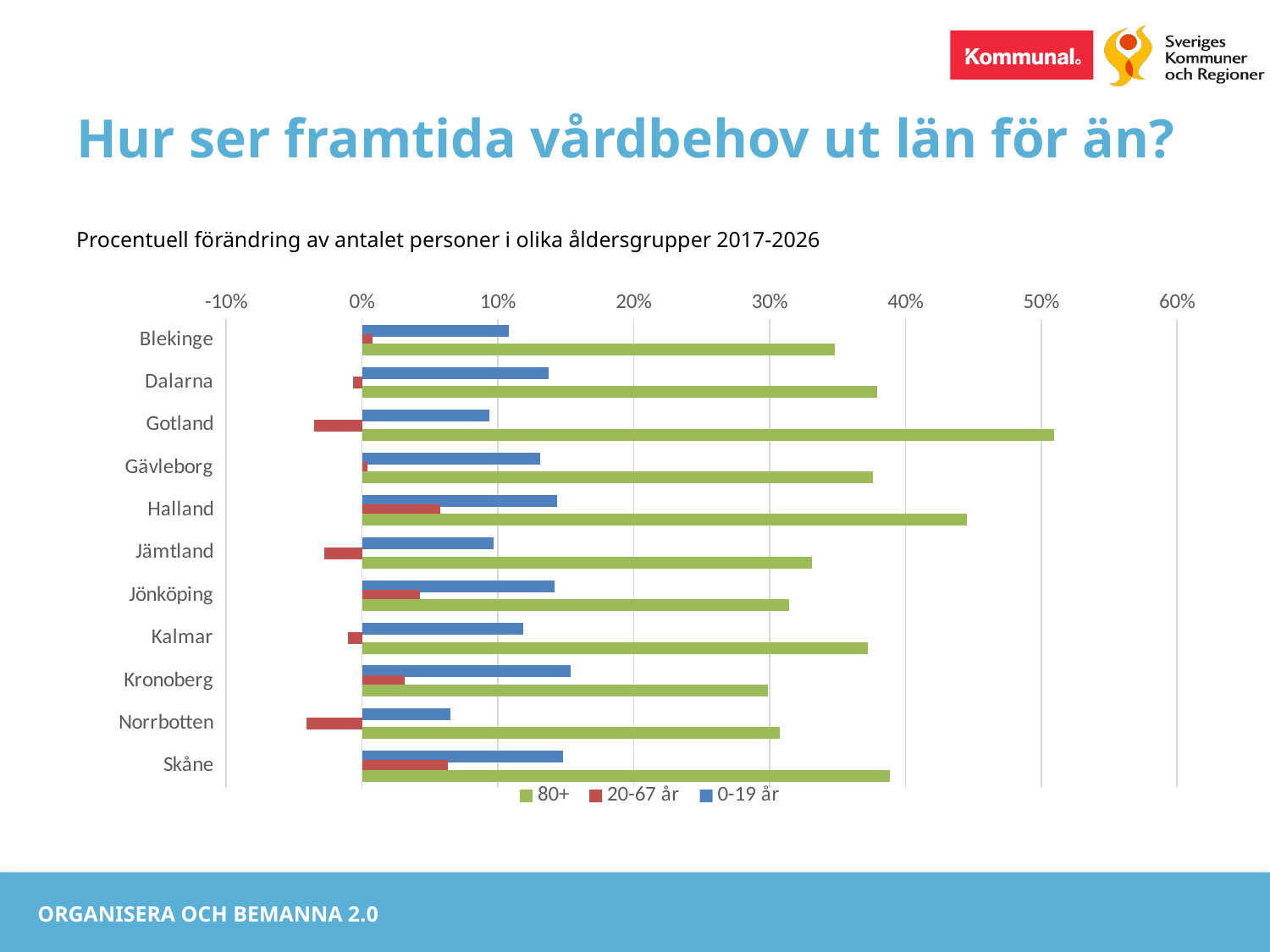
Which is larger, the 0-19 år value for Dalarna or the 0-19 år value for Blekinge? Dalarna What kind of chart is shown on the slide? bar chart Which county has the lowest value for the 0-19 år series? Norrbotten Which is larger, the 80+ value for Gotland or the 80+ value for Halland? Gotland Which series is shown in green in the legend? 80+ How many counties (categories) are listed on the chart? 11 Is the 80+ value for Gotland greater or less than 40%? greater Is the 80+ value for Halland greater or less than 40%? greater Which county has the highest value for the 80+ series? Gotland Is the 20-67 år value for Gotland greater or less than 0%? less How many series does the legend list? 3